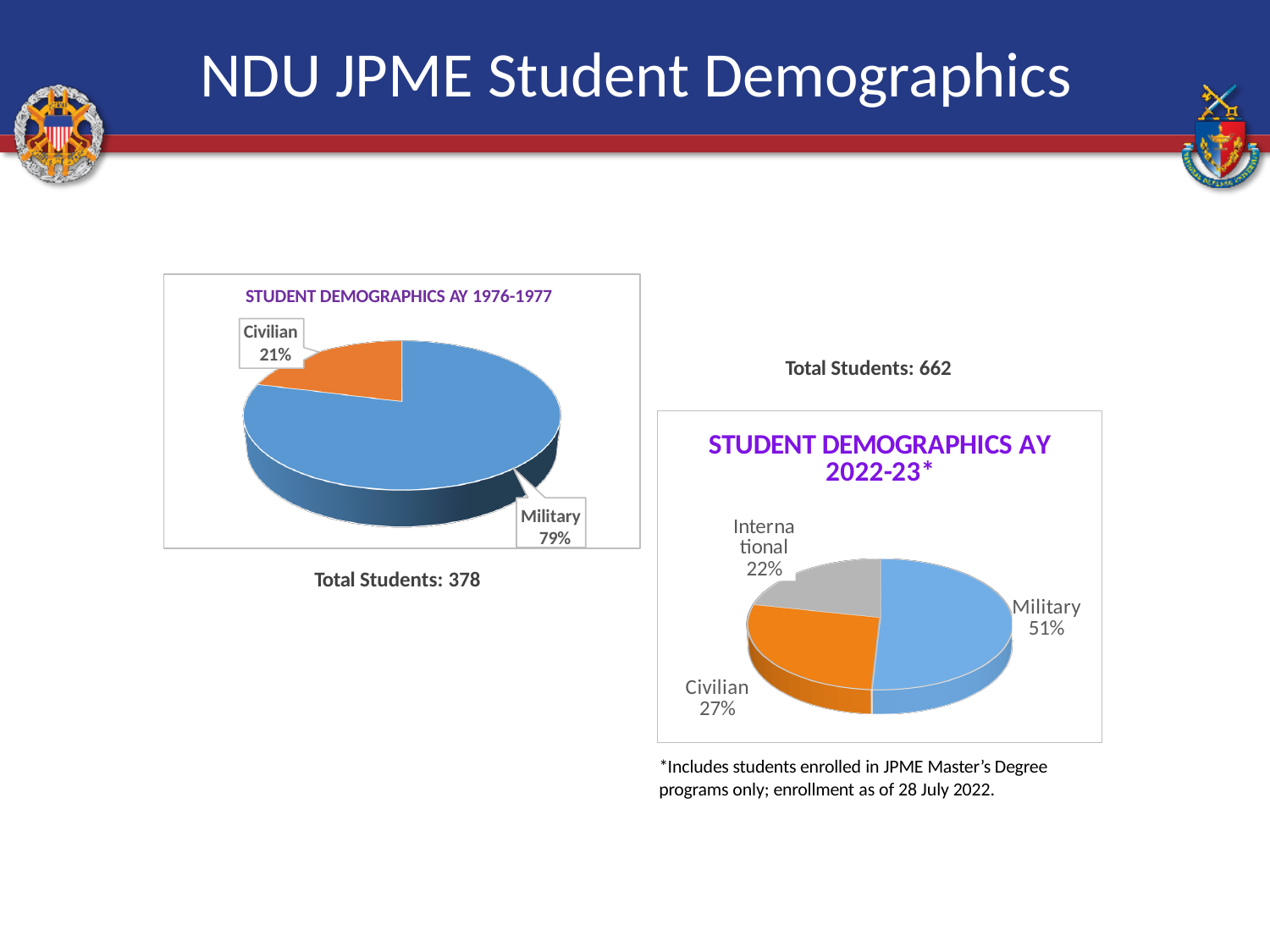
In the 'Student Demographics AY 1976-1977' chart, what share of students is Military? 79% In the 'Student Demographics AY 2022-23*' chart, is the Civilian share larger or smaller than the International share? larger In the 'Student Demographics AY 1976-1977' chart, what is the difference in percentage points between the Military and Civilian shares? 58 In the 'Student Demographics AY 1976-1977' chart, what share of students is Civilian? 21% What is the total number of students stated below the 'Student Demographics AY 1976-1977' chart? 378 In the 'Student Demographics AY 2022-23*' chart, what share of students is International? 22% In the 'Student Demographics AY 2022-23*' chart, which category has the largest slice? Military In the 'Student Demographics AY 2022-23*' chart, which category has the smallest slice? International How many categories does the 'Student Demographics AY 2022-23*' chart show? 3 What kind of chart is the 'Student Demographics AY 1976-1977' chart? pie chart In the 'Student Demographics AY 2022-23*' chart, what share of students is Civilian? 27% How many categories does the 'Student Demographics AY 1976-1977' chart show? 2